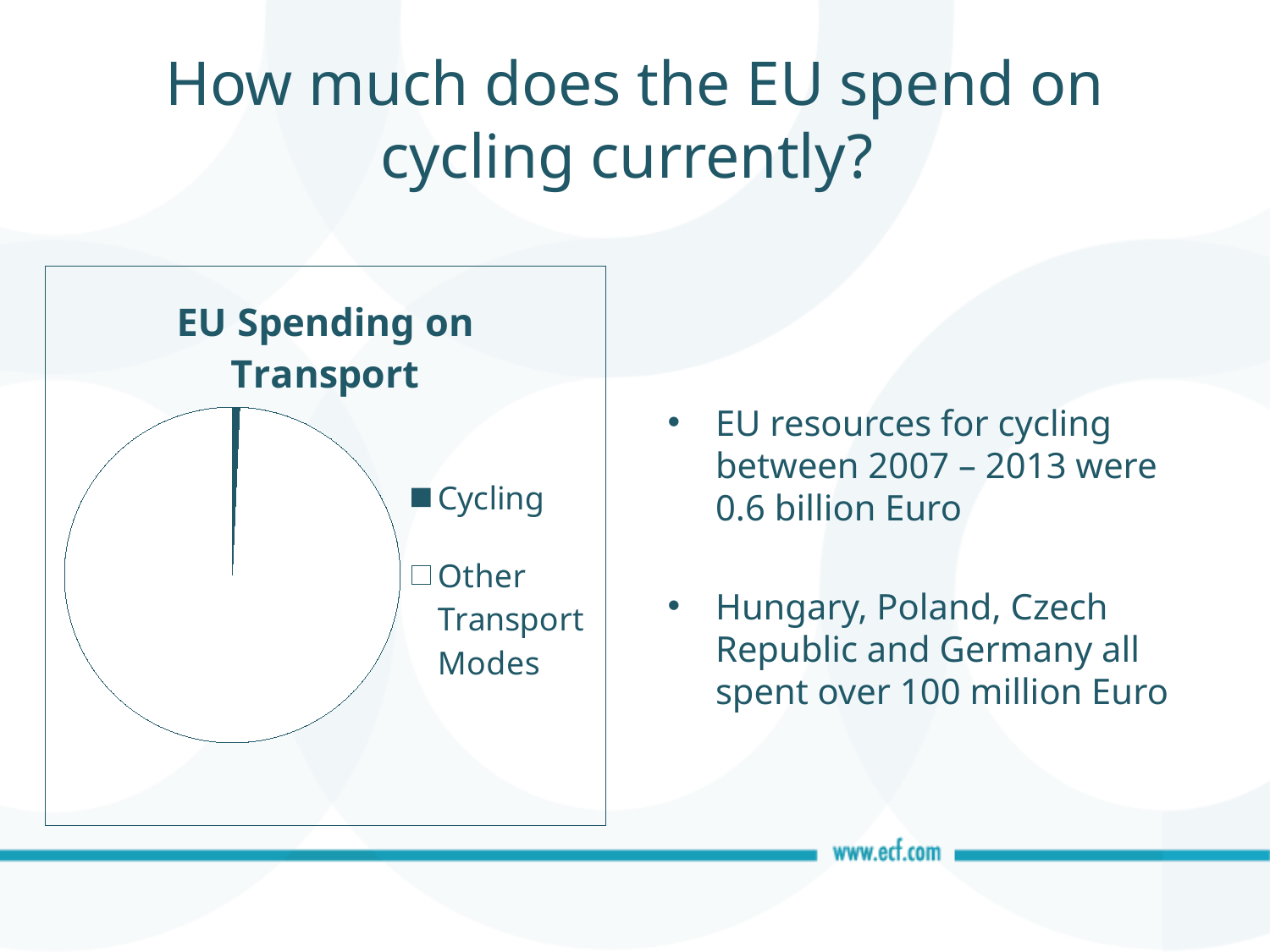
What are the two legend entries of the pie chart? Cycling; Other Transport Modes What kind of chart is shown on the slide? pie chart Which category has the largest slice of the pie? Other Transport Modes Which category has the smallest slice of the pie? Cycling What is the title of the chart? EU Spending on Transport Which slice is larger, Cycling or Other Transport Modes? Other Transport Modes How many categories does the pie chart show? 2